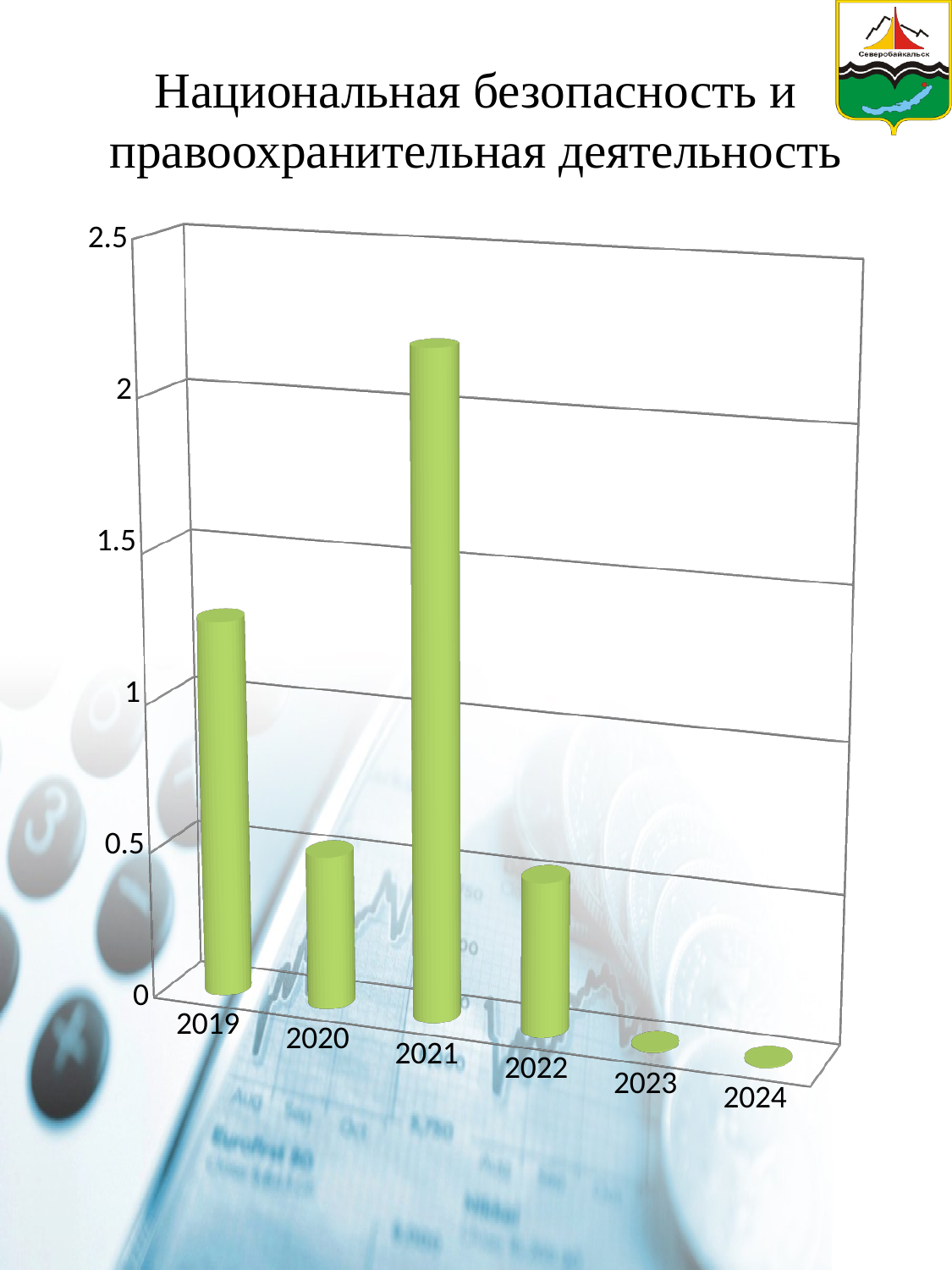
What kind of chart is shown on the slide? bar chart Is the value for 2021 greater or less than 2? greater What is the title of the slide containing the chart? Национальная безопасность и правоохранительная деятельность Which is larger, the value for 2021 or the value for 2019? 2021 Which year has the highest value in the chart? 2021 Do the values rise or fall from 2021 to 2024? fall What colour are the bars in the chart? green How many years are shown on the x axis of the chart? 6 Is the value for 2020 greater or less than 1? less Is the value for 2022 greater or less than 1? less Which is larger, the value for 2019 or the value for 2020? 2019